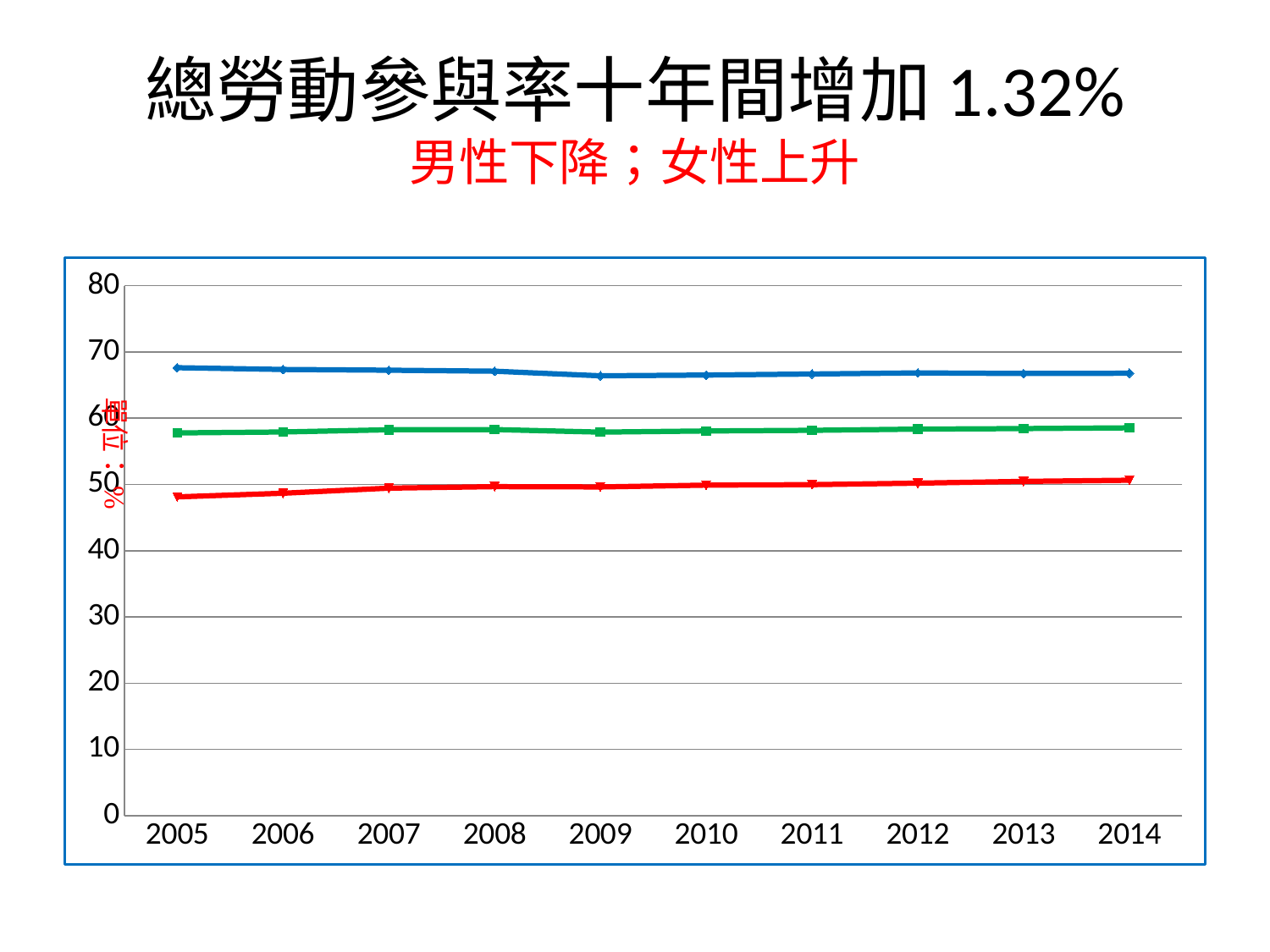
Is the value of the red line in 2005 greater or less than 50? less Is the value of the blue line in 2005 greater or less than 60? greater Is the value of the green line in 2010 greater or less than 50? greater How many lines are plotted on the chart? 3 How many years are shown on the x axis of the chart? 10 What kind of chart is shown on the slide? line chart Which line is the lowest across all years: the blue, green or red line? red Which line is the highest across all years: the blue, green or red line? blue In 2010, which is larger: the blue line or the green line? blue line Does the red line rise or fall from 2005 to 2014? rise What unit is given on the y axis label of the chart? %